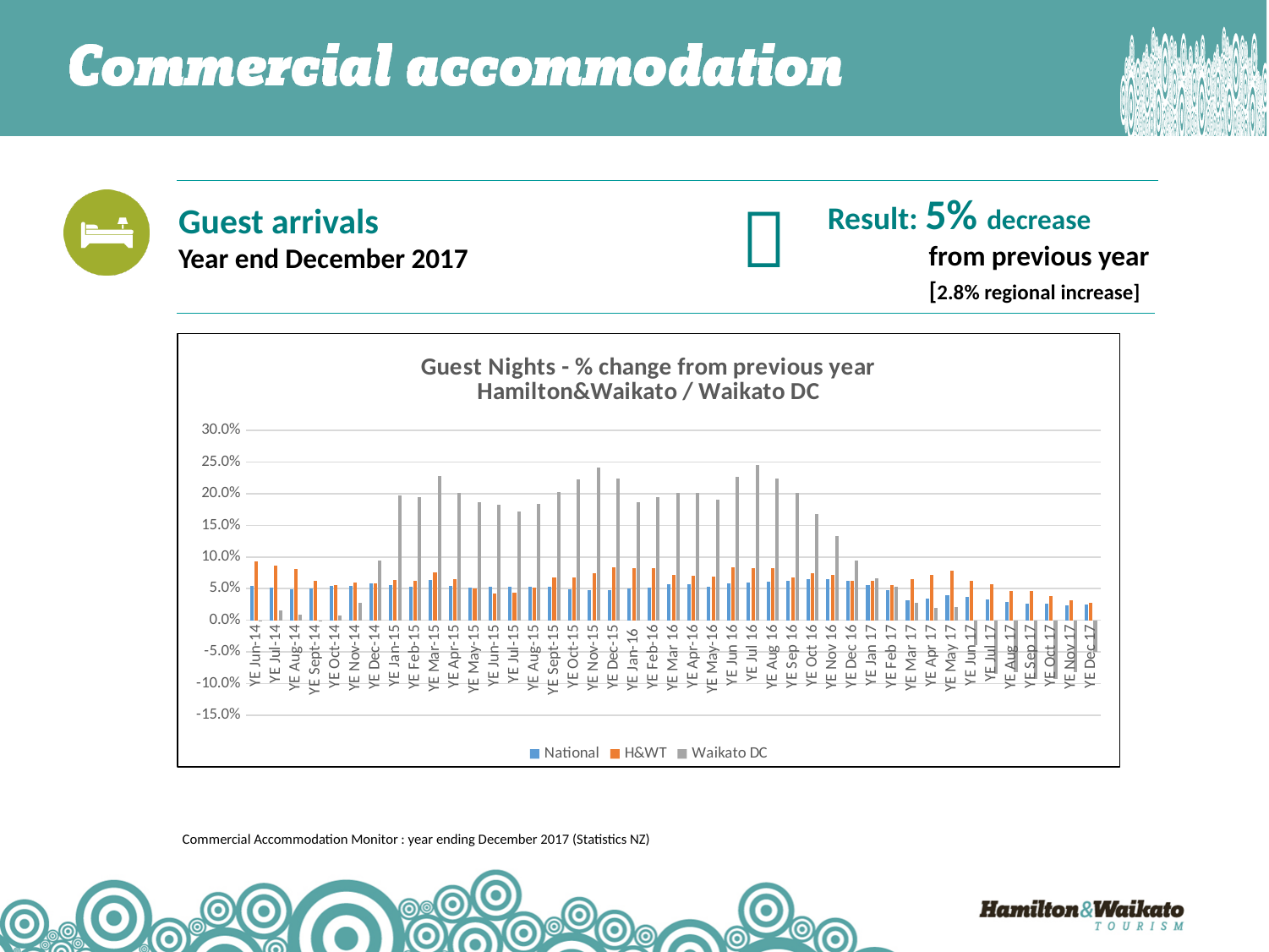
At YE Mar-15, which series has the larger value, Waikato DC or H&WT? Waikato DC Is the H&WT value for YE Jun-14 greater or less than 5.0%? greater What is the title of the chart? Guest Nights - % change from previous year Hamilton&Waikato / Waikato DC Do the Waikato DC values rise or fall from YE Jan 17 to YE Dec 17? fall At YE Jun-14, which series has the larger value, H&WT or National? H&WT What are the three series named in the chart legend? National, H&WT, Waikato DC What kind of chart is shown on the slide? Bar chart Is the Waikato DC value for YE Dec 17 greater or less than 0.0%? less Is the Waikato DC value for YE Jul 16 greater or less than 20.0%? greater How many series does the chart legend list? 3 How many year-end periods are shown along the x axis of the chart? 43